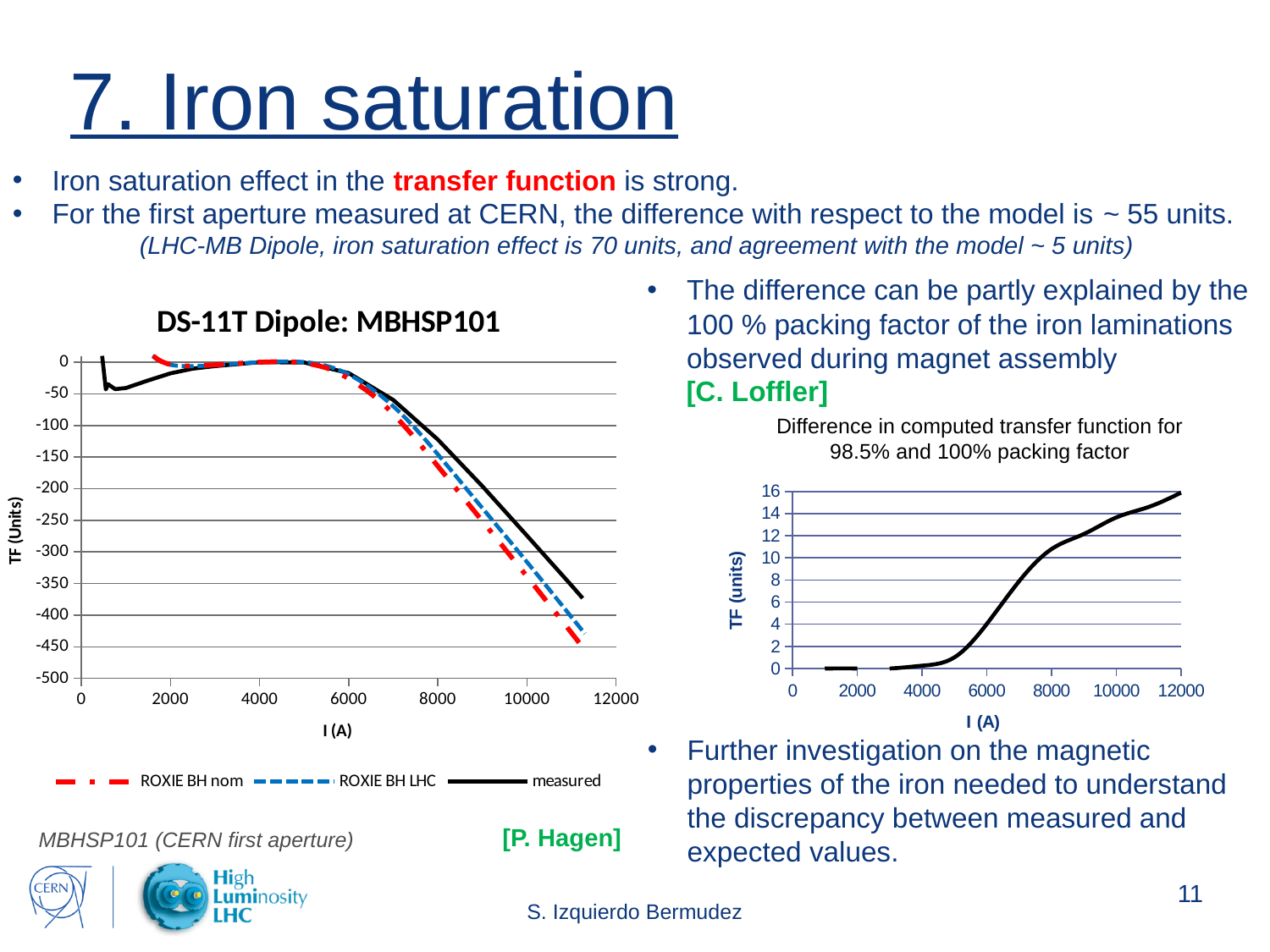
In the DS-11T Dipole: MBHSP101 chart, is the measured value at 11000 A greater or less than -300? less What kind of chart is the DS-11T Dipole: MBHSP101 chart? line chart In the DS-11T Dipole: MBHSP101 chart, which series is drawn as a solid black line? measured In the 'Difference in computed transfer function for 98.5% and 100% packing factor' chart, is the value at 4000 A greater or less than 2? less What is the y-axis title of the DS-11T Dipole: MBHSP101 chart? TF (Units) In the 'Difference in computed transfer function for 98.5% and 100% packing factor' chart, do the TF values rise or fall as I (A) increases? rise In the DS-11T Dipole: MBHSP101 chart, is the ROXIE BH nom value at 10000 A greater or less than -300? less What kind of chart is the 'Difference in computed transfer function for 98.5% and 100% packing factor' chart? line chart In the DS-11T Dipole: MBHSP101 chart, do the TF values rise or fall as the current I (A) increases beyond about 6000 A? fall How many series does the legend of the DS-11T Dipole: MBHSP101 chart list? 3 In the DS-11T Dipole: MBHSP101 chart, at 10000 A, which series has the higher (less negative) TF value, measured or ROXIE BH nom? measured